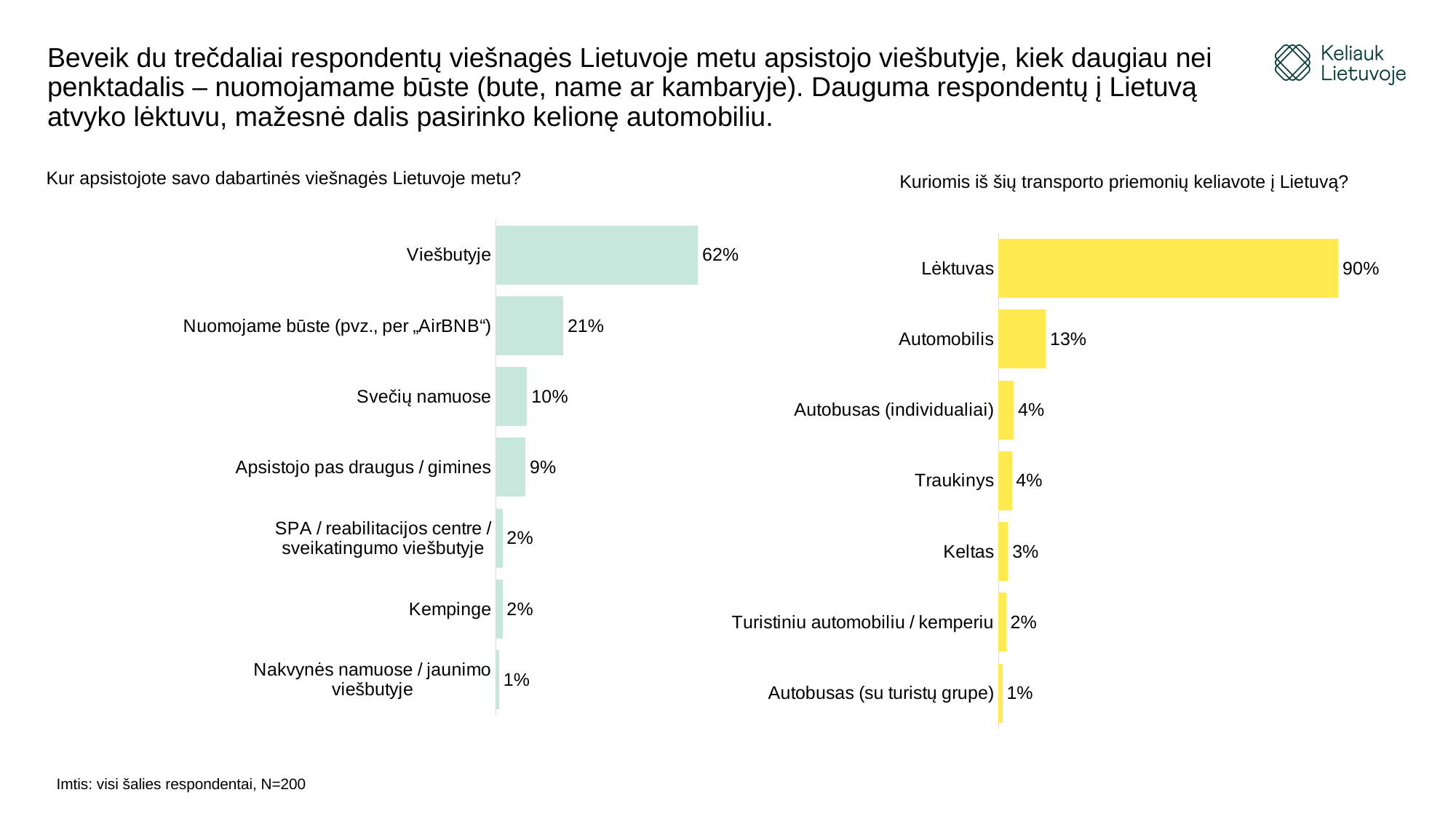
What kind of chart is the right chart (Kuriomis iš šių transporto priemonių keliavote į Lietuvą?)? Bar chart In the right chart (Kuriomis iš šių transporto priemonių keliavote į Lietuvą?), which category has the highest value? Lėktuvas What colour are the bars in the right chart (Kuriomis iš šių transporto priemonių keliavote į Lietuvą?)? Yellow In the left chart (Kur apsistojote savo dabartinės viešnagės Lietuvoje metu?), what is the difference between Viešbutyje and Nuomojame būste (pvz., per „AirBNB“)? 41% In the right chart (Kuriomis iš šių transporto priemonių keliavote į Lietuvą?), what is the value for Keltas? 3% In the left chart (Kur apsistojote savo dabartinės viešnagės Lietuvoje metu?), which category has the lowest value? Nakvynės namuose / jaunimo viešbutyje In the right chart (Kuriomis iš šių transporto priemonių keliavote į Lietuvą?), which is larger: Automobilis or Traukinys? Automobilis In the right chart (Kuriomis iš šių transporto priemonių keliavote į Lietuvą?), what is the value for Lėktuvas? 90% In the right chart (Kuriomis iš šių transporto priemonių keliavote į Lietuvą?), what is the difference between Lėktuvas and Automobilis? 77% In the left chart (Kur apsistojote savo dabartinės viešnagės Lietuvoje metu?), what is the value for Viešbutyje? 62% In the left chart (Kur apsistojote savo dabartinės viešnagės Lietuvoje metu?), what is the value for Svečių namuose? 10% In the left chart (Kur apsistojote savo dabartinės viešnagės Lietuvoje metu?), how many categories are shown? 7